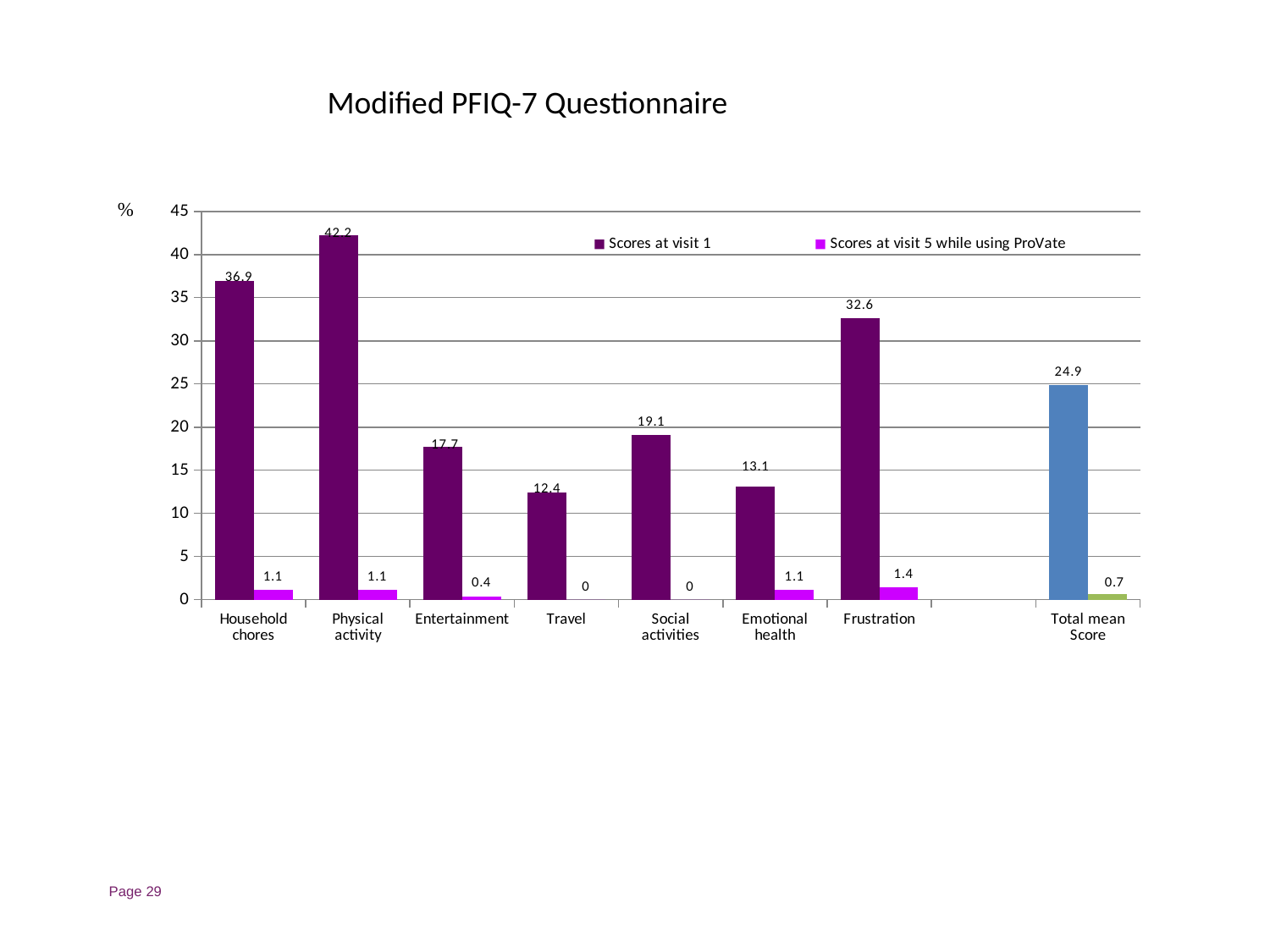
Which category has the lowest score at visit 1 (excluding Total mean Score)? Travel What is the title of the chart? Modified PFIQ-7 Questionnaire Is the visit 1 score for Frustration greater or less than 30? greater How many series does the legend list? 2 What is the score at visit 5 while using ProVate for Frustration? 1.4 How many categories are shown on the x axis? 8 Which is larger: the visit 1 score for Social activities or for Entertainment? Social activities What is the difference between the visit 1 score and the visit 5 score for Household chores? 35.8 Which category has the highest score at visit 1? Physical activity What is the score at visit 1 for Physical activity? 42.2 What kind of chart is shown on the slide? Bar chart What is the Total mean Score at visit 1? 24.9